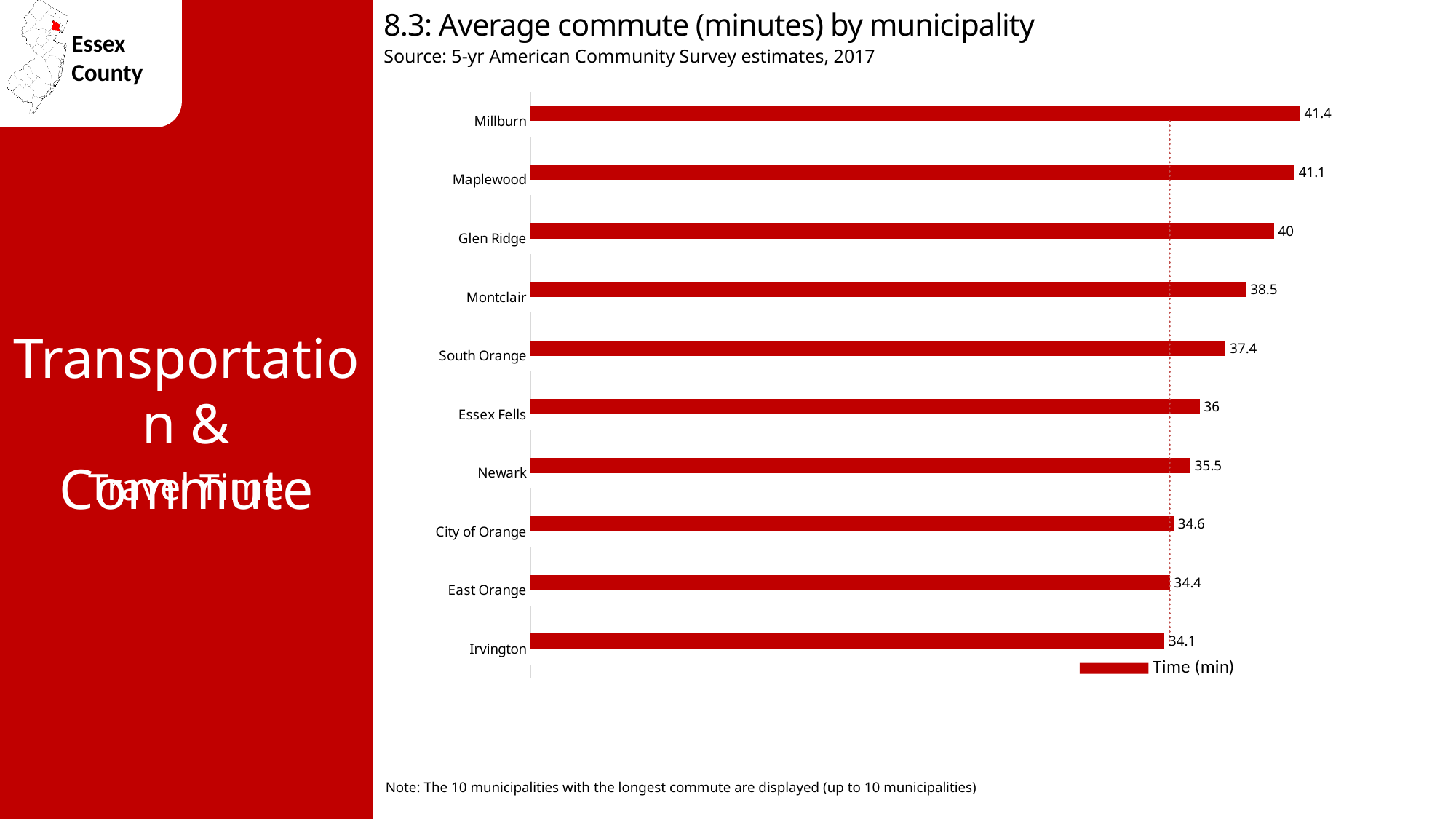
What is the legend entry for the series in the chart? Time (min) What is the average commute time for Montclair? 38.5 How many municipalities are shown in the chart? 10 Which municipality has the longest average commute? Millburn Which municipality shown has the shortest average commute? Irvington What is the difference in average commute time between Glen Ridge and Essex Fells? 4 How many series does the legend list? 1 Which has a longer average commute, Maplewood or South Orange? Maplewood What is the difference in average commute time between Millburn and Irvington? 7.3 What type of chart is shown on the slide? Bar chart What is the average commute time for Millburn? 41.4 What is the average commute time for Newark? 35.5